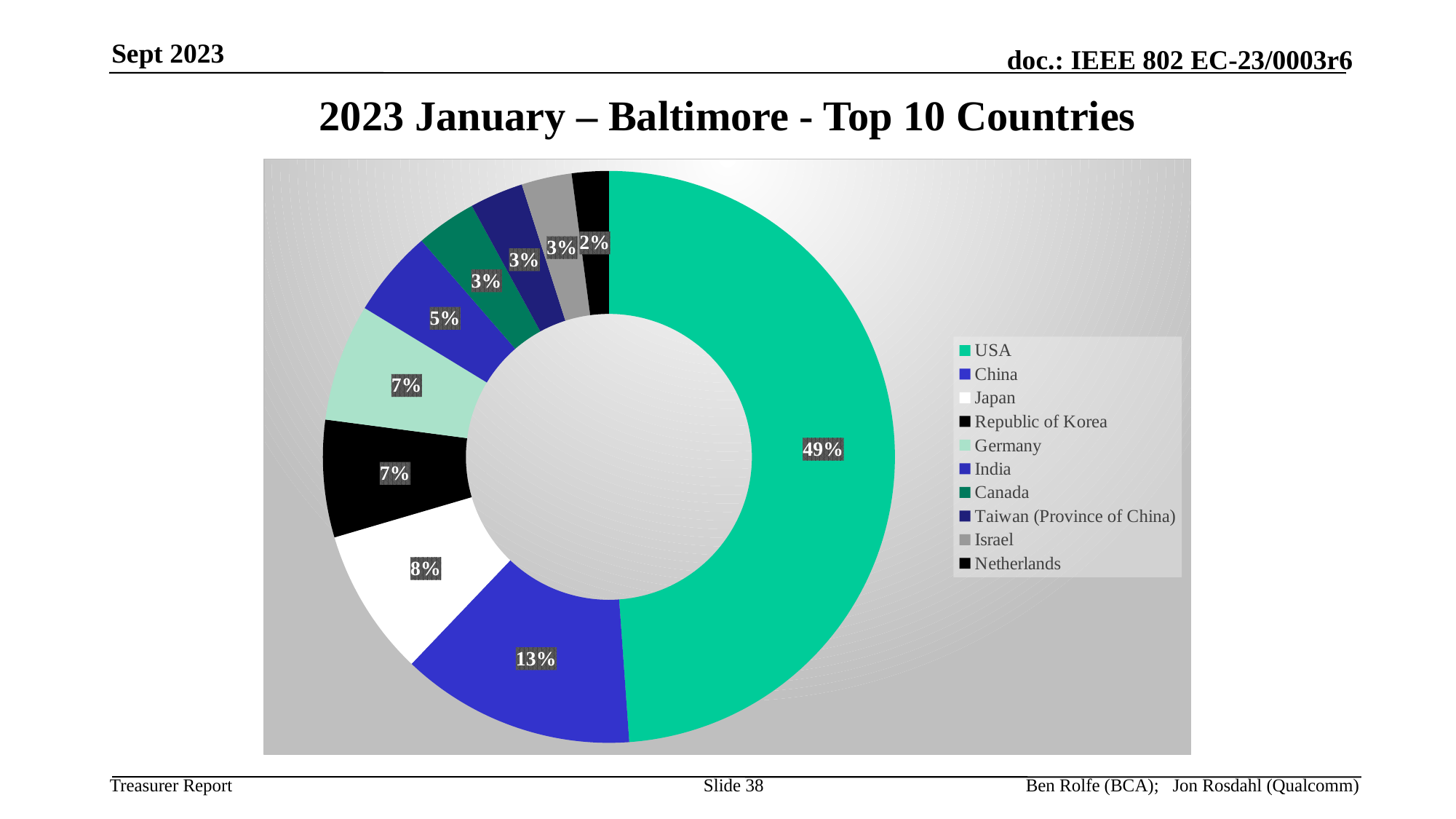
What is the difference in percentage points between USA and China? 36 What percentage is shown for China? 13% What is the title of the chart on the slide? 2023 January – Baltimore - Top 10 Countries What percentage is shown for Japan? 8% What percentage is shown for India? 5% Which country has the largest share in the chart? USA Which has a larger share, Japan or India? Japan What percentage is shown for Netherlands? 2% How many countries are listed in the legend? 10 What type of chart is shown on the slide? Doughnut chart Which country has the smallest share in the chart? Netherlands What share of the chart does USA account for? 49%